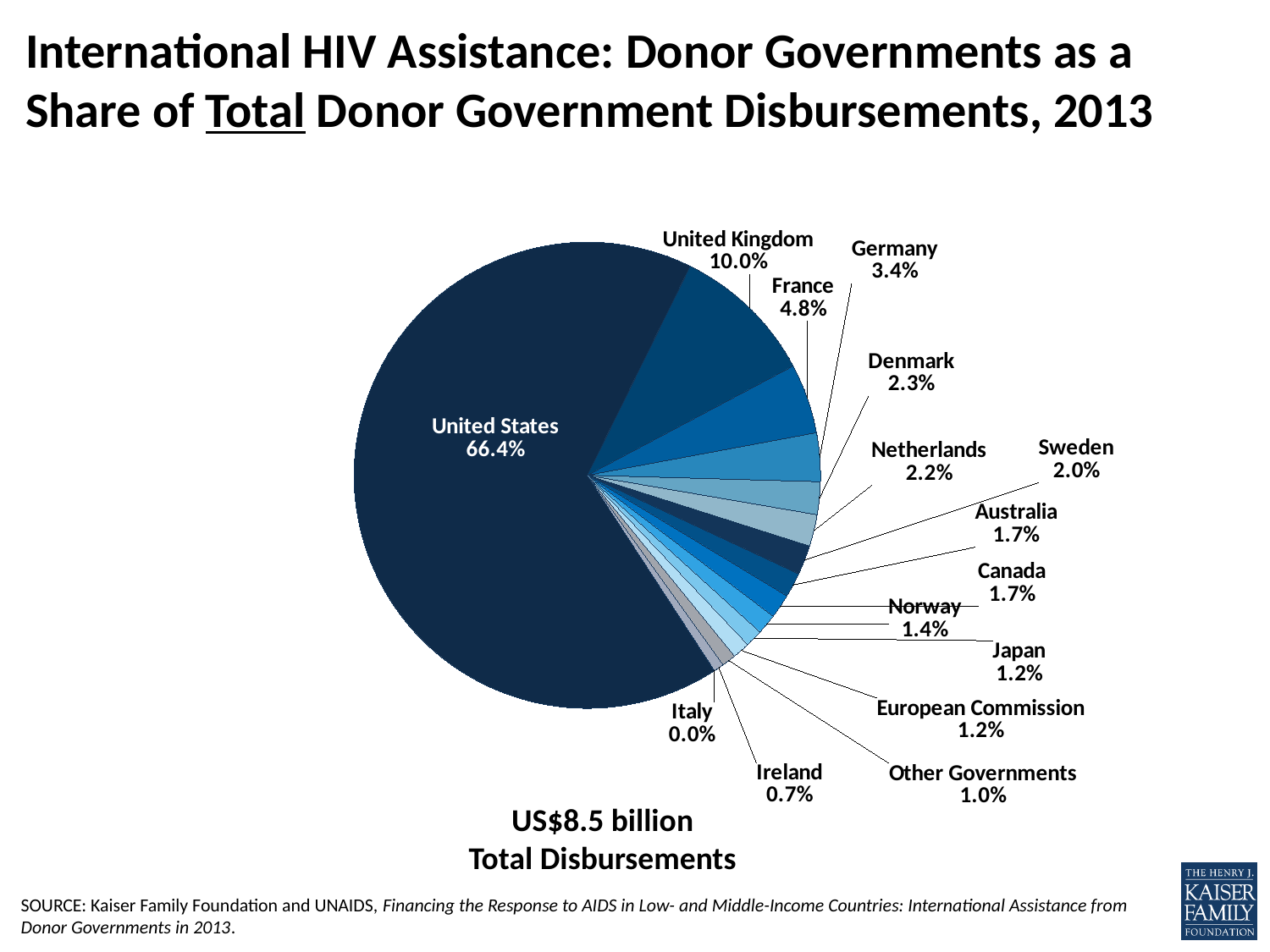
What total disbursement amount is stated below the pie chart? US$8.5 billion Which donor has the smallest share shown on the pie? Italy What share is shown for Germany? 3.4% What is the difference between Germany's share and Denmark's share? 1.1% How much larger is the United Kingdom's share than France's share? 5.2% What share of total donor government disbursements does the United States account for? 66.4% Which donor government has the largest share of the pie? United States How many slices (donor categories) are labelled on the pie chart? 15 What share is shown for the European Commission? 1.2% What type of chart is shown on the slide? Pie chart What is the share shown for the United Kingdom? 10.0% Which has a larger share, the Netherlands or Sweden? Netherlands